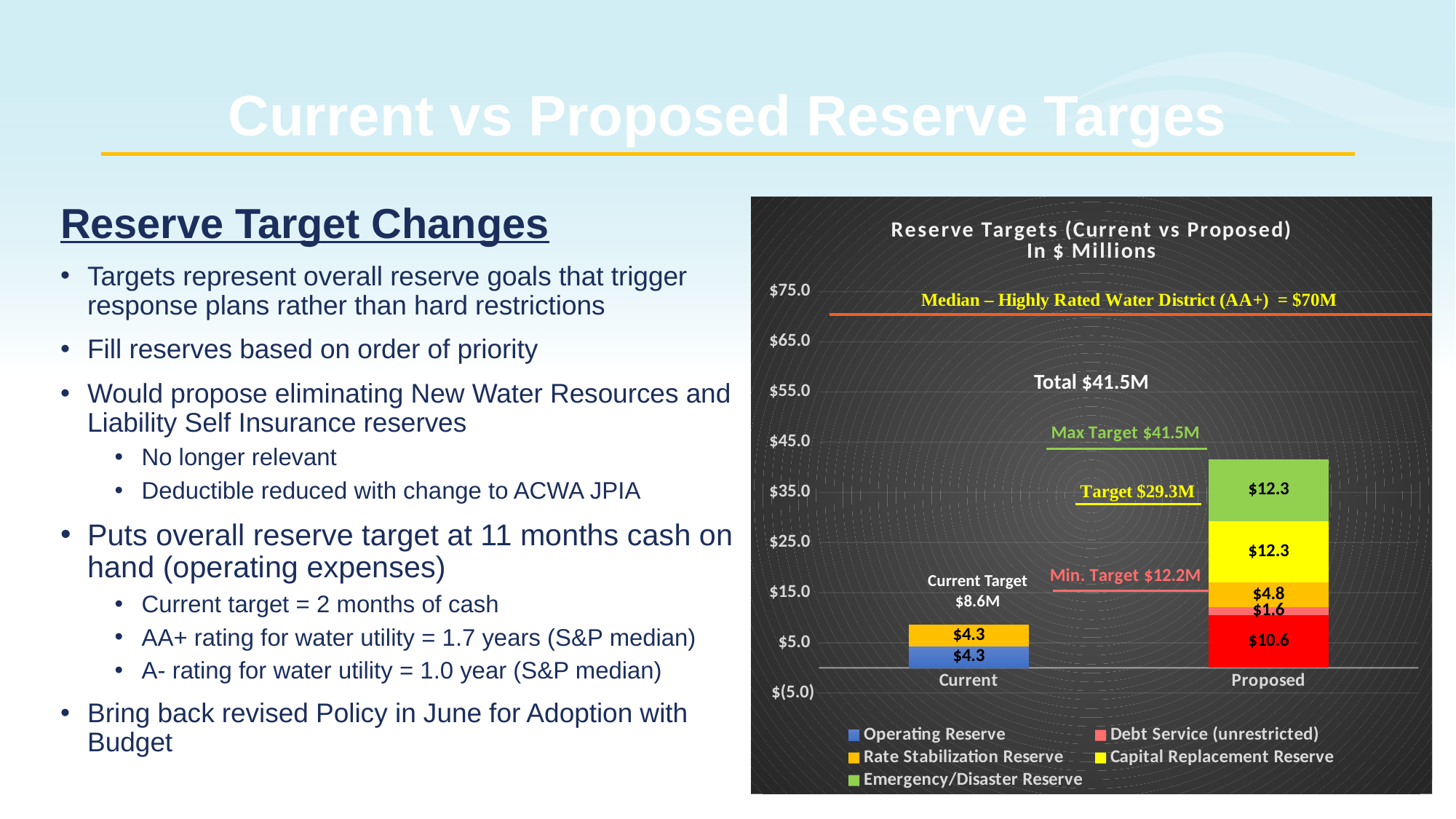
What is the total of the Current stacked bar? $8.6M Which bar is taller, Current or Proposed? Proposed What kind of chart is shown on the slide? Stacked bar chart What is the difference between the Rate Stabilization Reserve segment in the Proposed bar and in the Current bar? $0.5 What is the value of the Debt Service (unrestricted) segment in the Proposed bar? $1.6 What is the value of the Capital Replacement Reserve segment in the Proposed bar? $12.3 How many categories are shown on the x axis of the chart? 2 How many series does the chart legend list? 5 Is the top of the Proposed bar greater or less than $35.0? greater What value is given for the Median – Highly Rated Water District (AA+) line on the chart? $70M What is the value of the Rate Stabilization Reserve segment in the Proposed bar? $4.8 What is the value of the Operating Reserve segment in the Current bar? $4.3